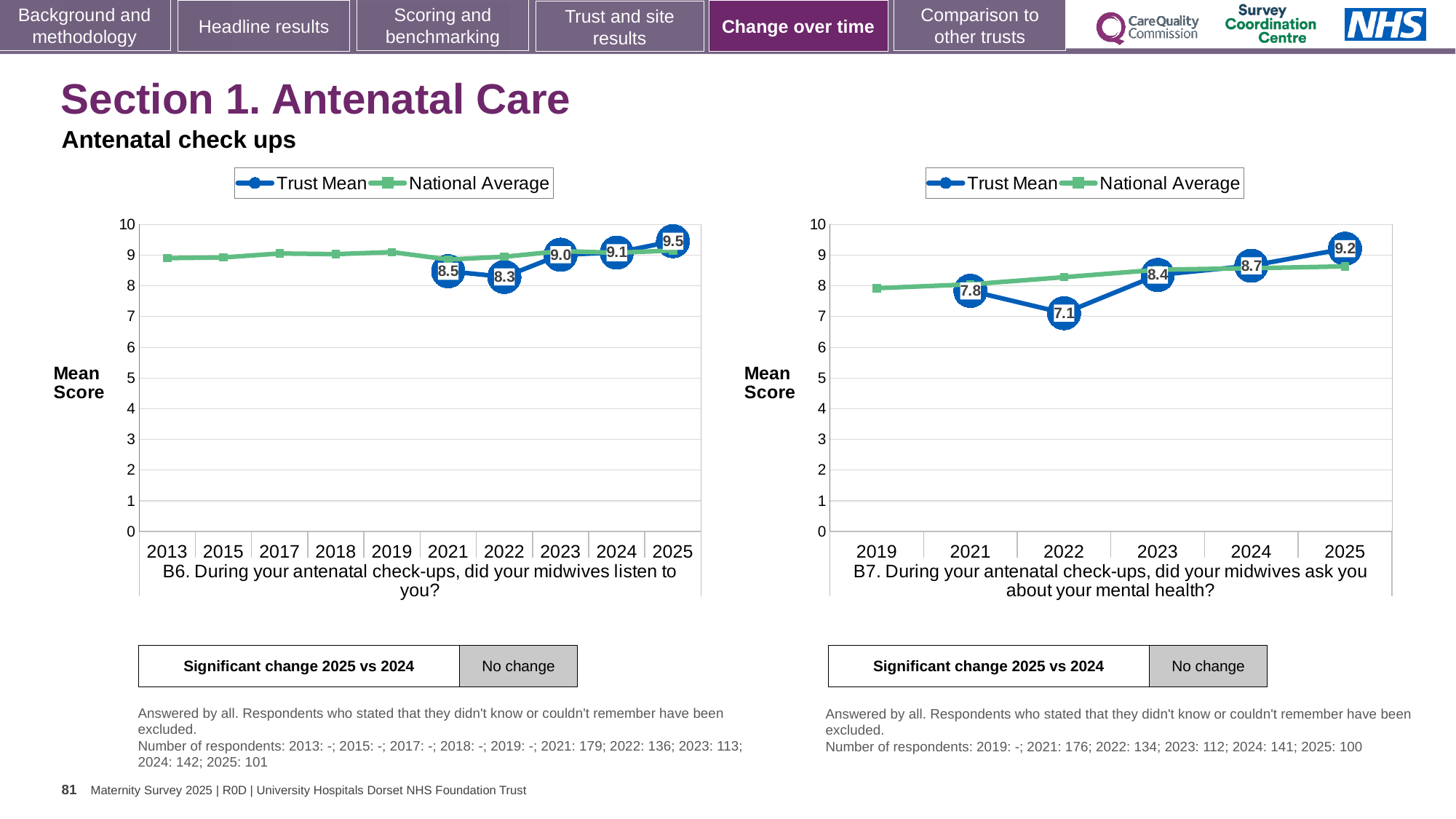
In the B6 chart (left), what is the Trust Mean score for 2022? 8.3 In the B7 chart (right), what is the Trust Mean score for 2022? 7.1 How many years are shown on the x axis of the B6 chart (left)? 10 In the B7 chart (right), is the National Average value for 2019 greater or less than 9? less In the B7 chart (right), what is the difference between the Trust Mean scores for 2025 and 2022? 2.1 In the B6 chart (left), which year has the highest Trust Mean score? 2025 In the B6 chart (left), is the Trust Mean score for 2023 or 2022 larger? 2023 In the B6 chart (left), what is the Trust Mean score for 2025? 9.5 How many series does the legend of the B7 chart (right) list? 2 In the B7 chart (right), what is the Trust Mean score for 2024? 8.7 In the B7 chart (right), which year has the lowest Trust Mean score? 2022 What type of chart is used for the B7 chart (right)? Line chart